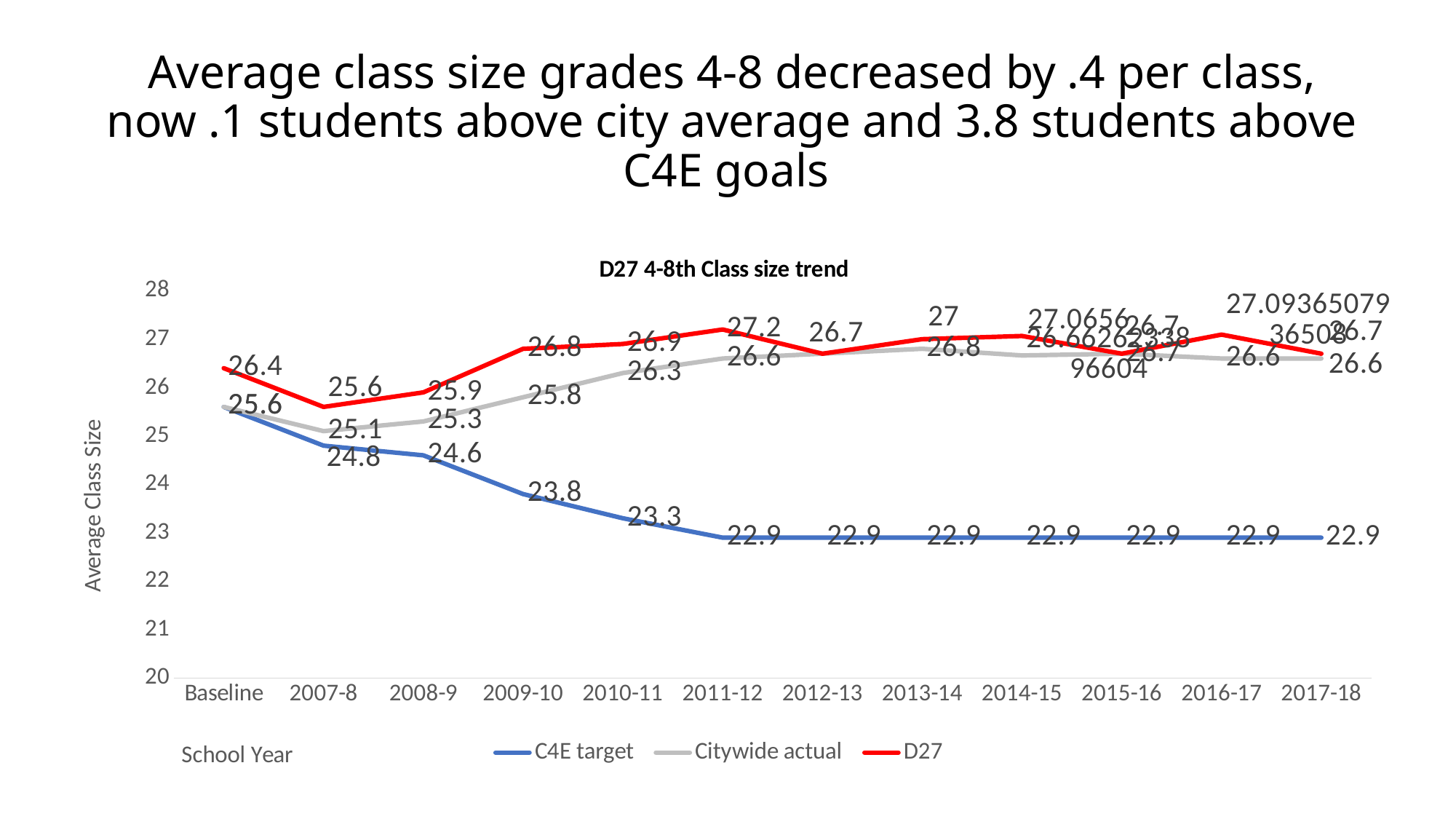
How many school-year points are plotted along the x axis? 12 What is the difference between the D27 value and the C4E target value in 2017-18? 3.8 At which school year is the D27 series lowest? 2007-8 What is the D27 value for 2011-12? 27.2 At which school year is the C4E target series highest? Baseline Is the C4E target value for 2011-12 greater or less than 23? less What is the title of the y axis? Average Class Size What is the Citywide actual value for 2010-11? 26.3 In 2009-10, which is larger: the D27 value or the Citywide actual value? D27 What is the C4E target value for 2009-10? 23.8 How many series does the legend list? 3 What kind of chart is shown on the slide? line chart